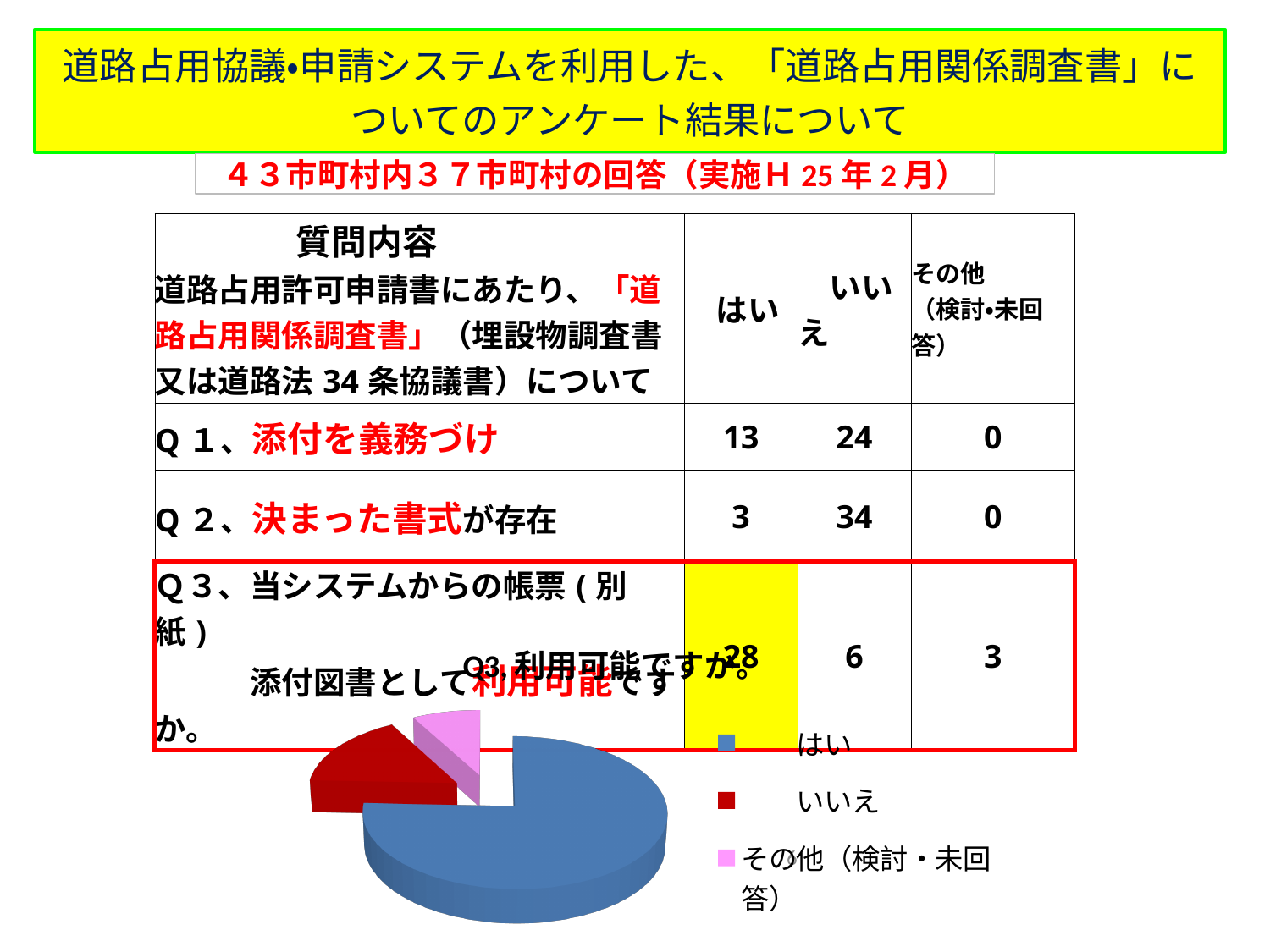
What colour is the はい slice in the pie chart? blue How many slices does the pie chart have? 3 Which legend entry is shown in red in the pie chart? いいえ What kind of chart is shown on the slide? pie chart Which category has the largest slice in the pie chart? はい How many entries does the legend of the pie chart list? 3 Which category has the smallest slice in the pie chart? その他（検討・未回答） In the pie chart, which slice is larger: いいえ or その他（検討・未回答）? いいえ In the pie chart, which slice is larger: はい or いいえ? はい